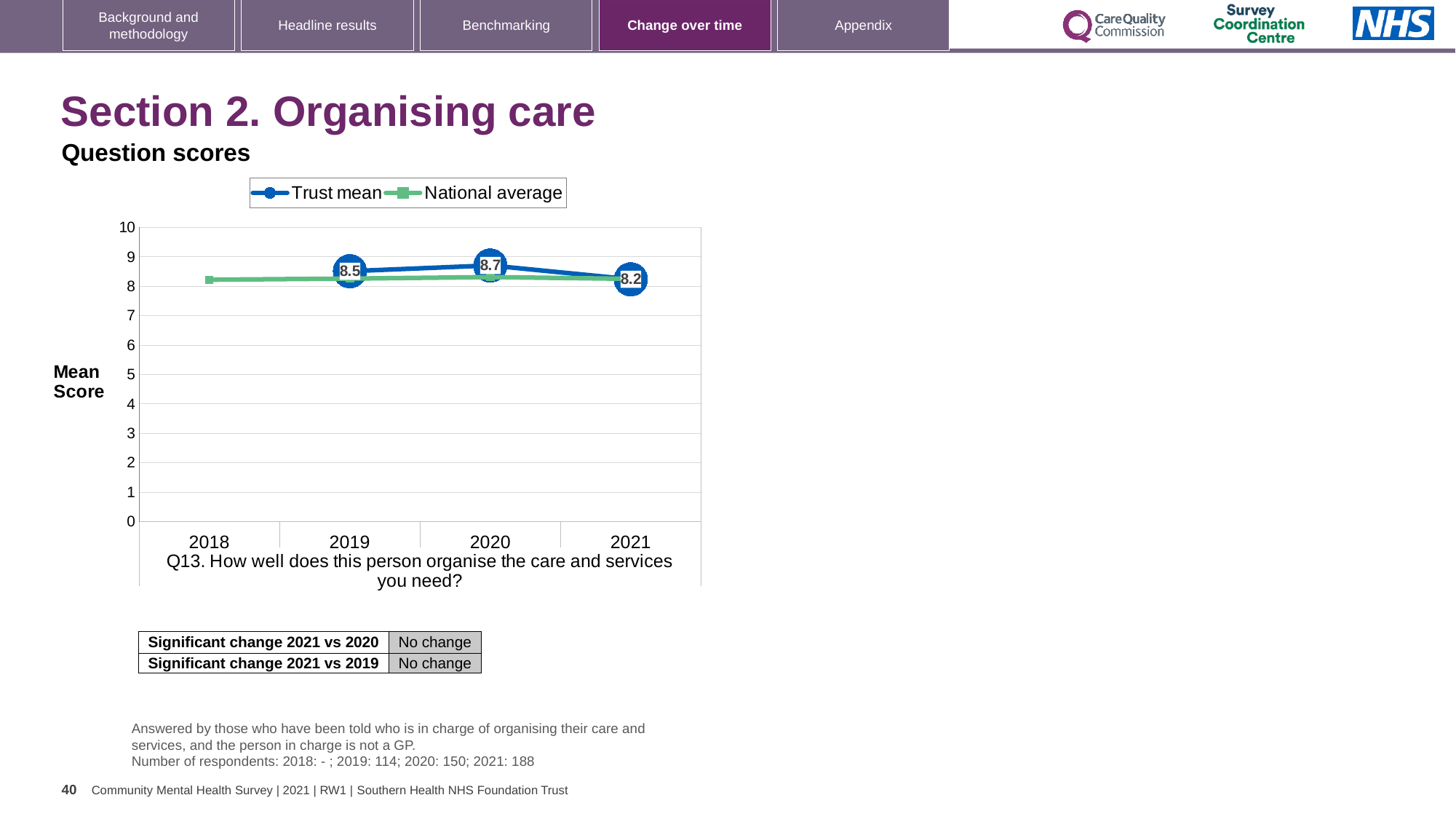
What is the difference between the Trust mean in 2020 and in 2021? 0.5 Is the National average for 2018 greater or less than 7? greater In which year is the Trust mean lowest? 2021 Does the Trust mean rise or fall from 2020 to 2021? Fall Which is larger, the Trust mean in 2019 or in 2020? 2020 What is the Trust mean score for 2021? 8.2 How many years are shown on the x axis? 4 In which year is the Trust mean highest? 2020 What kind of chart is shown? Line chart How many series does the legend list? 2 What is the Trust mean score for 2020? 8.7 What is the Trust mean score for 2019? 8.5